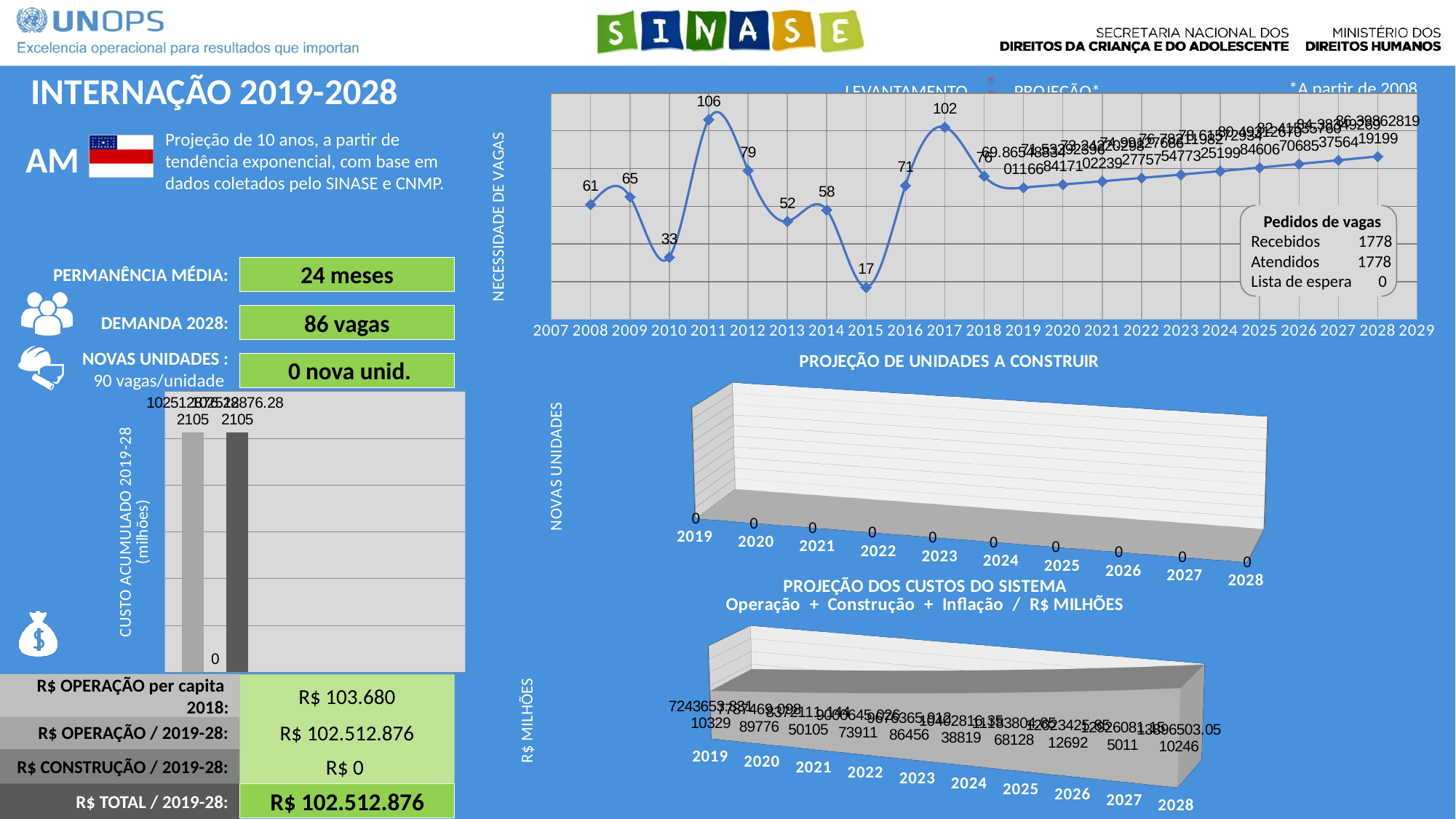
In the NECESSIDADE DE VAGAS line chart, which year has the lowest value? 2015 In the NECESSIDADE DE VAGAS line chart, which year has the larger value, 2012 or 2013? 2012 In the NECESSIDADE DE VAGAS line chart, what is the value for 2017? 102 In the PROJEÇÃO DE UNIDADES A CONSTRUIR chart, what is the value for 2019? 0 How many years are shown on the x axis of the PROJEÇÃO DE UNIDADES A CONSTRUIR chart? 10 In the NECESSIDADE DE VAGAS line chart, what is the value for 2015? 17 In the NECESSIDADE DE VAGAS line chart, which year has the highest value? 2011 In the NECESSIDADE DE VAGAS line chart, what is the value for 2011? 106 In the NECESSIDADE DE VAGAS line chart, what is the difference between the values for 2017 and 2016? 31 In the NECESSIDADE DE VAGAS line chart, what is the difference between the values for 2011 and 2015? 89 In the NECESSIDADE DE VAGAS chart, do the projected values from 2019 to 2028 rise or fall? rise